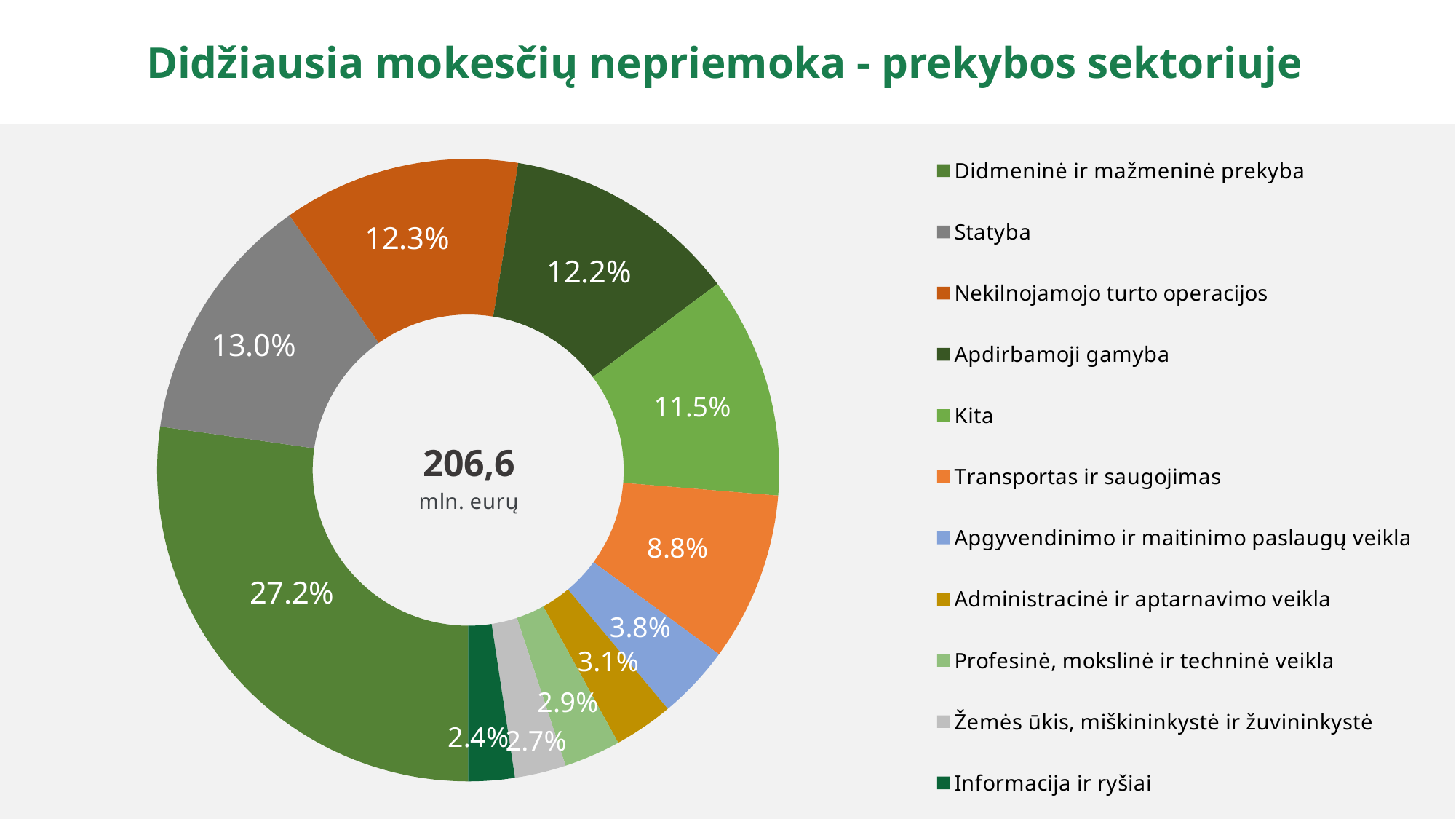
What total value is printed in the centre of the donut chart? 206,6 mln. eurų What kind of chart is shown on the slide? Pie chart (donut) How many categories does the legend list? 11 What share of the pie does Didmeninė ir mažmeninė prekyba hold? 27.2% Which category has the smallest share of the pie? Informacija ir ryšiai What is the value shown for Nekilnojamojo turto operacijos? 12.3% What is the value shown for Informacija ir ryšiai? 2.4% What is the value shown for Transportas ir saugojimas? 8.8% Which category has the largest share of the pie? Didmeninė ir mažmeninė prekyba Which is larger, the share for Kita or the share for Transportas ir saugojimas? Kita What is the difference between the shares of Statyba and Apdirbamoji gamyba? 0.8% What is the value shown for Statyba? 13.0%